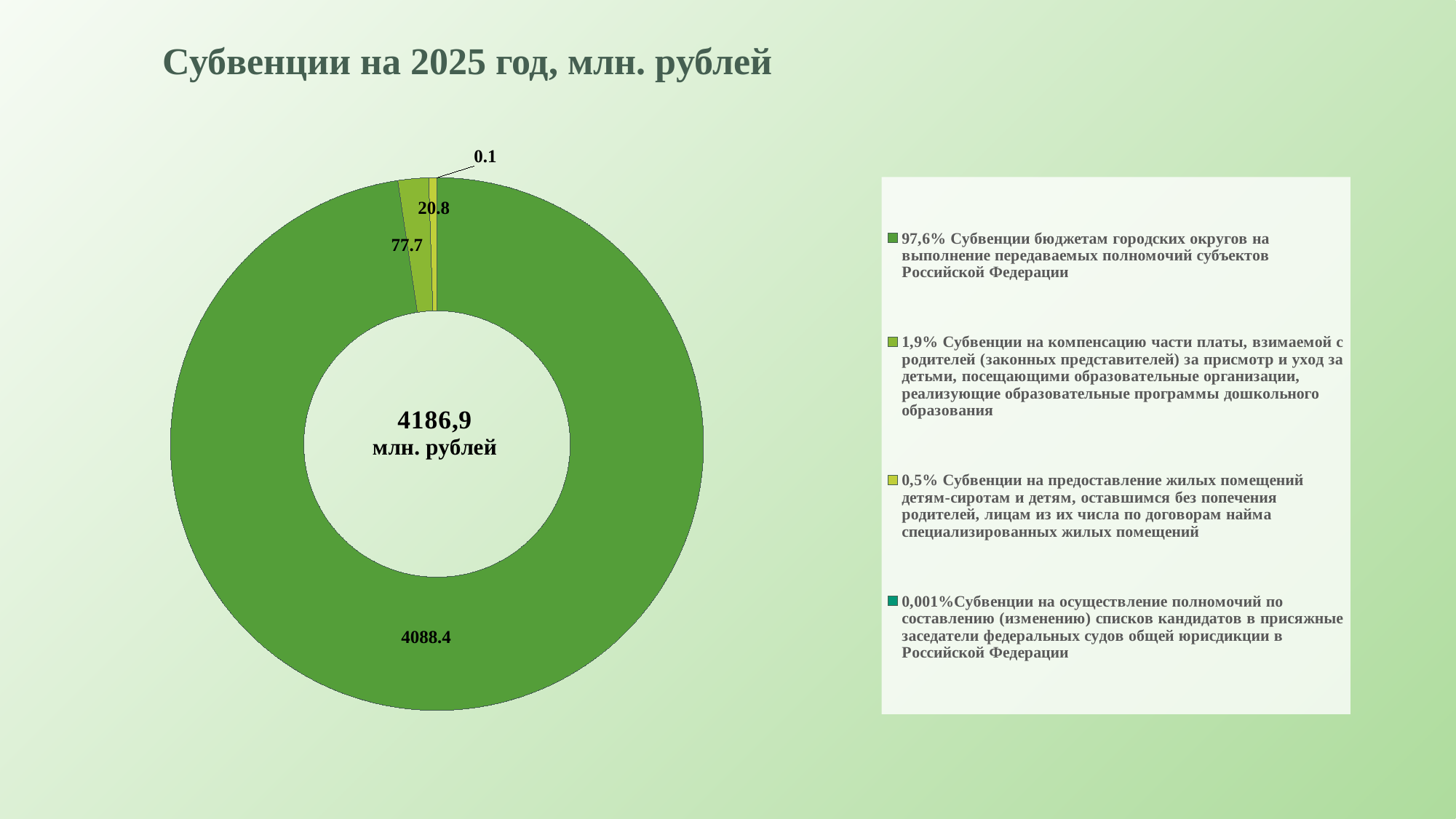
What is the value for 'Субвенции на компенсацию части платы, взимаемой с родителей (законных представителей) за присмотр и уход за детьми'? 77.7 What is the difference between the value for compensation of parental fees (77.7) and the value for housing for orphans (20.8)? 56.9 What is the value for 'Субвенции на осуществление полномочий по составлению (изменению) списков кандидатов в присяжные заседатели'? 0.1 Which category has the largest slice? Субвенции бюджетам городских округов на выполнение передаваемых полномочий субъектов Российской Федерации How many slices does the chart have? 4 What is the value for 'Субвенции бюджетам городских округов на выполнение передаваемых полномочий субъектов Российской Федерации'? 4088.4 What is the value for 'Субвенции на предоставление жилых помещений детям-сиротам и детям, оставшимся без попечения родителей'? 20.8 How many entries does the legend list? 4 What is the title of the chart? Субвенции на 2025 год, млн. рублей Which category has the smallest slice? Субвенции на осуществление полномочий по составлению (изменению) списков кандидатов в присяжные заседатели федеральных судов общей юрисдикции в Российской Федерации What share of the total do the subventions for compensation of part of parental fees (Субвенции на компенсацию части платы) represent? 1,9% What kind of chart is shown on the slide? doughnut (pie) chart